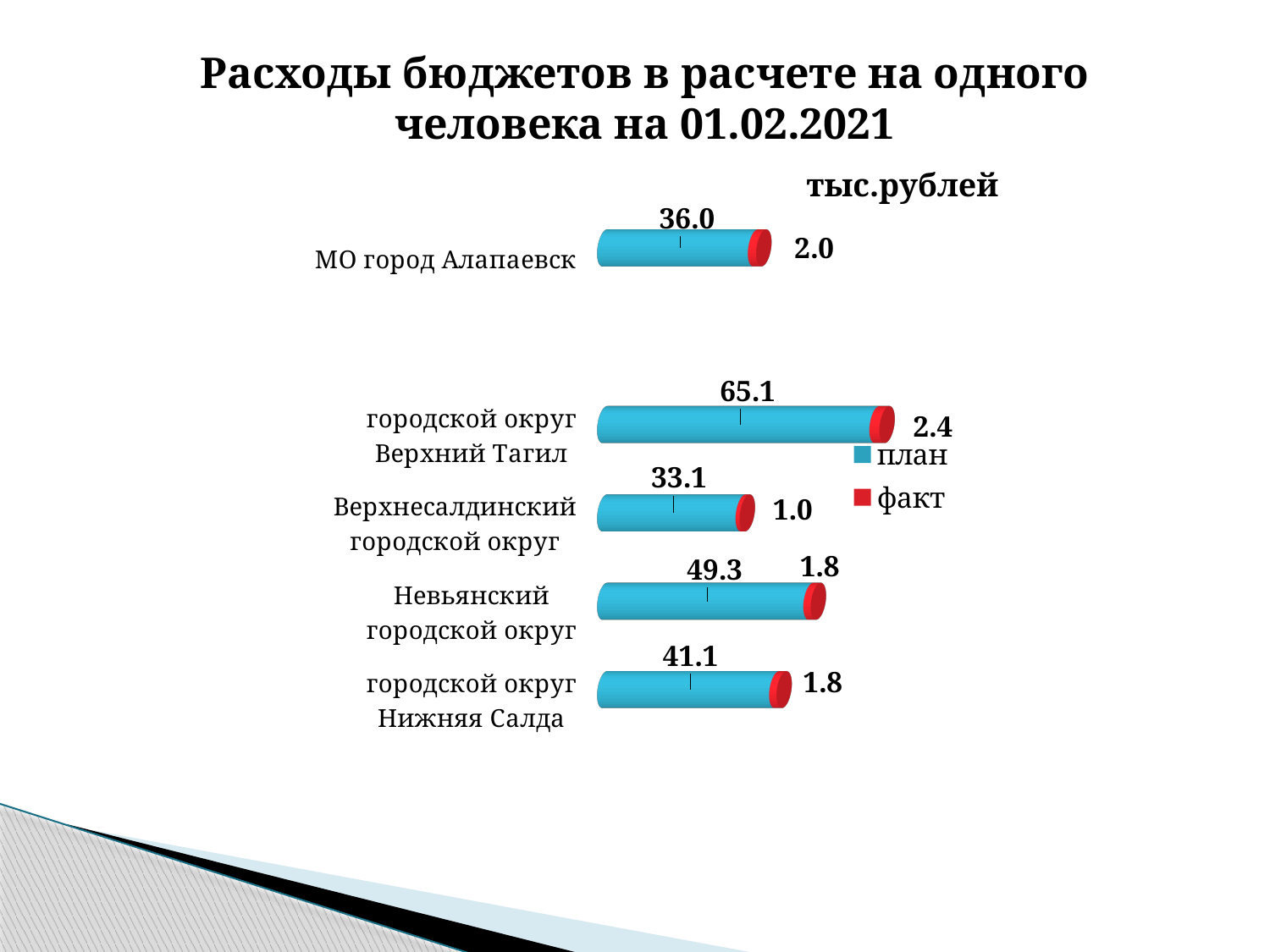
What is the difference between the план values for городской округ Верхний Тагил and Верхнесалдинский городской округ? 32.0 What is the факт value for Невьянский городской округ? 1.8 How many series does the legend list? 2 What kind of chart is shown on the slide? bar chart What unit is indicated for the values in the chart? тыс.рублей Which category has the highest план value? городской округ Верхний Тагил What is the план value for Верхнесалдинский городской округ? 33.1 Which category has the lowest факт value? Верхнесалдинский городской округ What is the факт value for МО город Алапаевск? 2.0 What is the план value for городской округ Верхний Тагил? 65.1 Which is larger, the план value for Невьянский городской округ or for городской округ Нижняя Салда? Невьянский городской округ How many categories are shown in the chart? 5